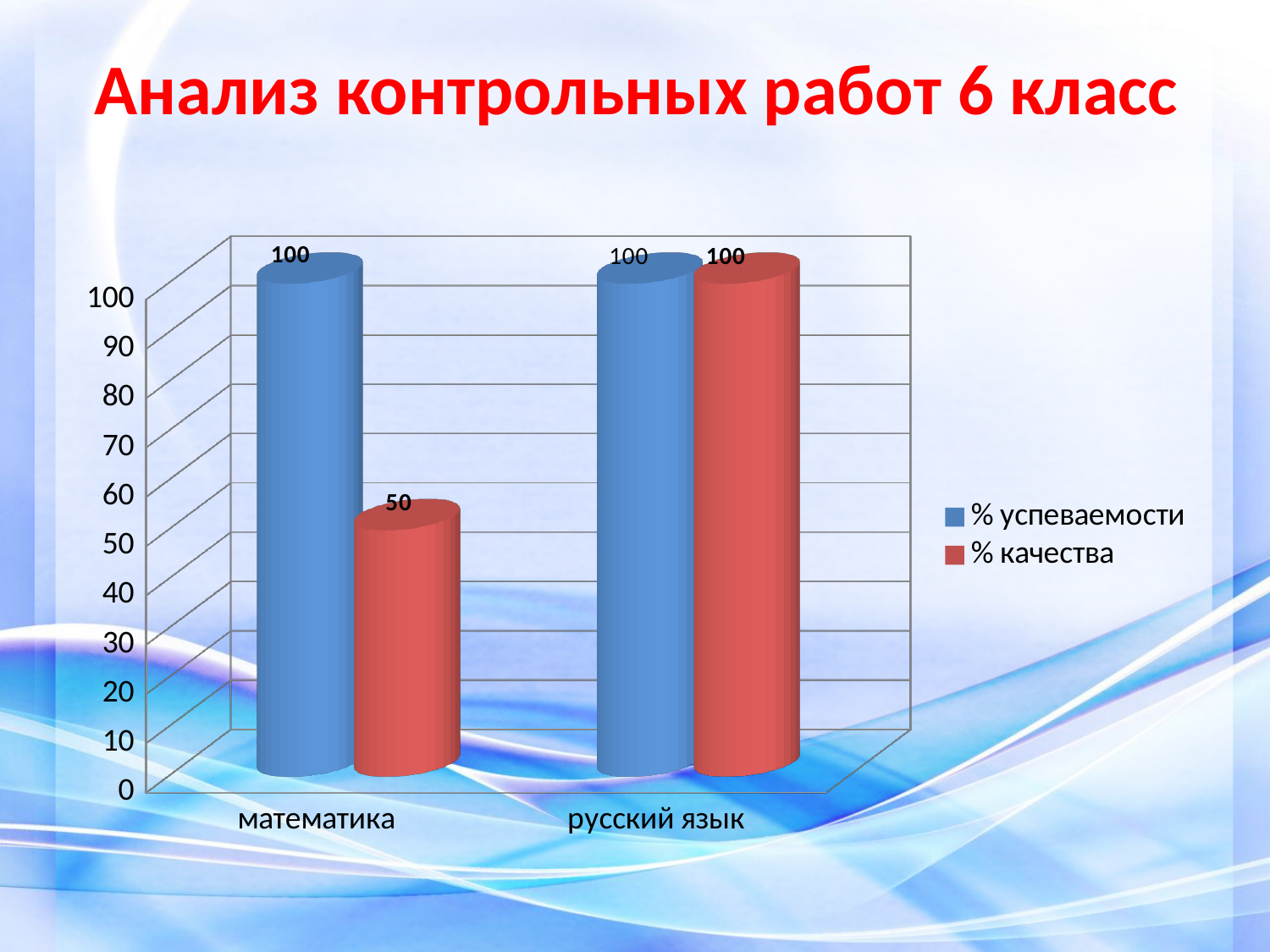
What is the value of % качества for математика? 50 How many series does the legend list? 2 What is the value of % качества for русский язык? 100 How many categories are shown on the x axis? 2 What is the title of the slide? Анализ контрольных работ 6 класс Is the value of % качества for математика greater or less than 60? less Which is larger for математика: % успеваемости or % качества? % успеваемости Which category has the lowest value for % качества? математика What is the difference between % успеваемости and % качества for математика? 50 What is the value of % успеваемости for русский язык? 100 What kind of chart is shown on the slide? bar chart What is the value of % успеваемости for математика? 100